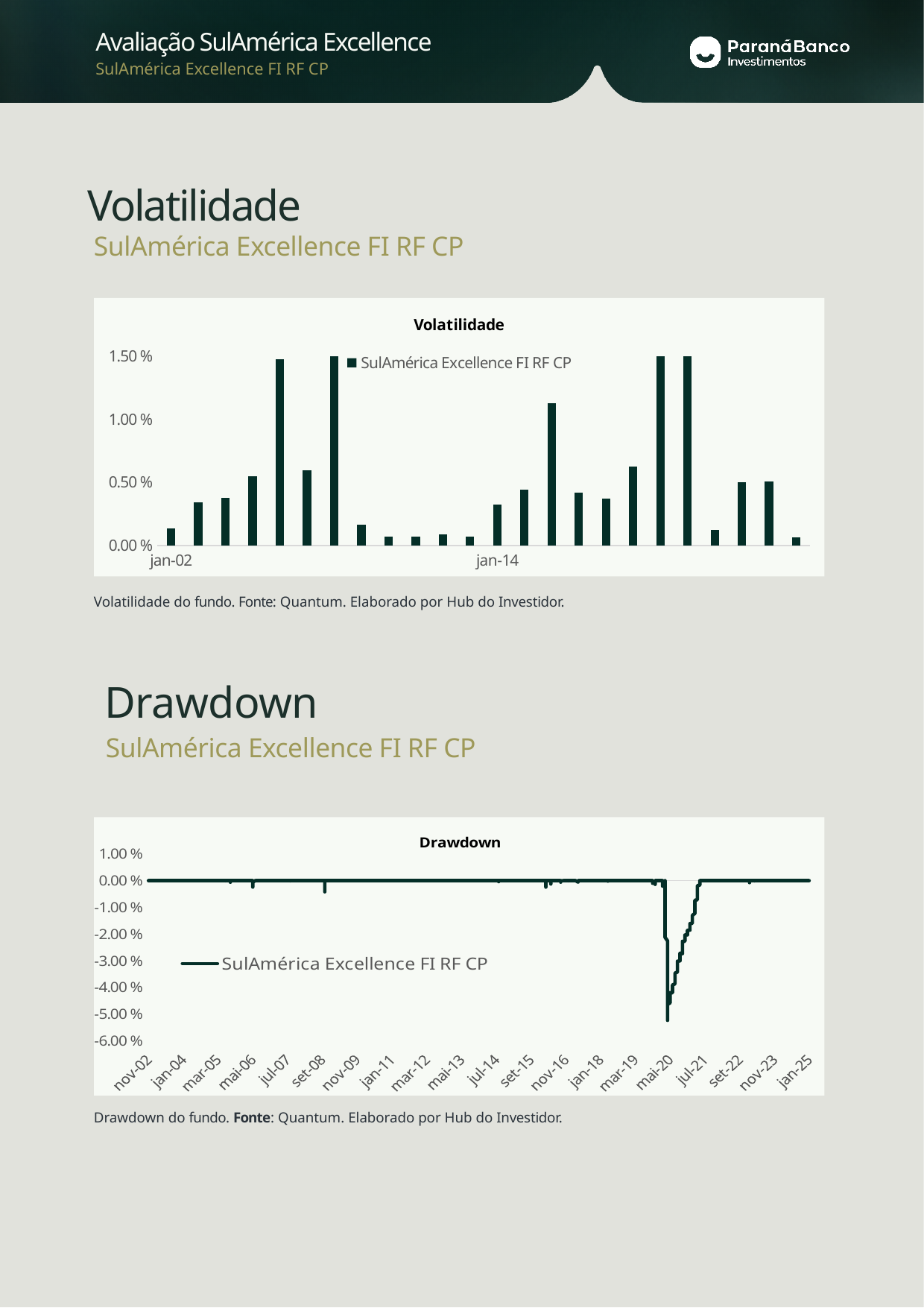
In the Volatilidade chart, is the tallest bar greater or less than 1.00 %? greater What series name appears in the legend of the Drawdown chart? SulAmérica Excellence FI RF CP In the Volatilidade chart, how many bars are plotted? 24 How many series does the legend of the Volatilidade chart list? 1 What kind of chart is the Volatilidade chart at the top of the slide? bar chart In the Volatilidade chart, is the value for jan-02 greater or less than 0.50 %? less In the Drawdown chart, is the lowest point of the line, around mai-20, greater or less than -4.00 %? less What kind of chart is the Drawdown chart at the bottom of the slide? line chart How many series does the legend of the Drawdown chart list? 1 In the Drawdown chart, does the line rise or fall between mai-20 and jul-21? rises In the Volatilidade chart, which is larger, the bar at jan-02 or the bar at jan-14? jan-14